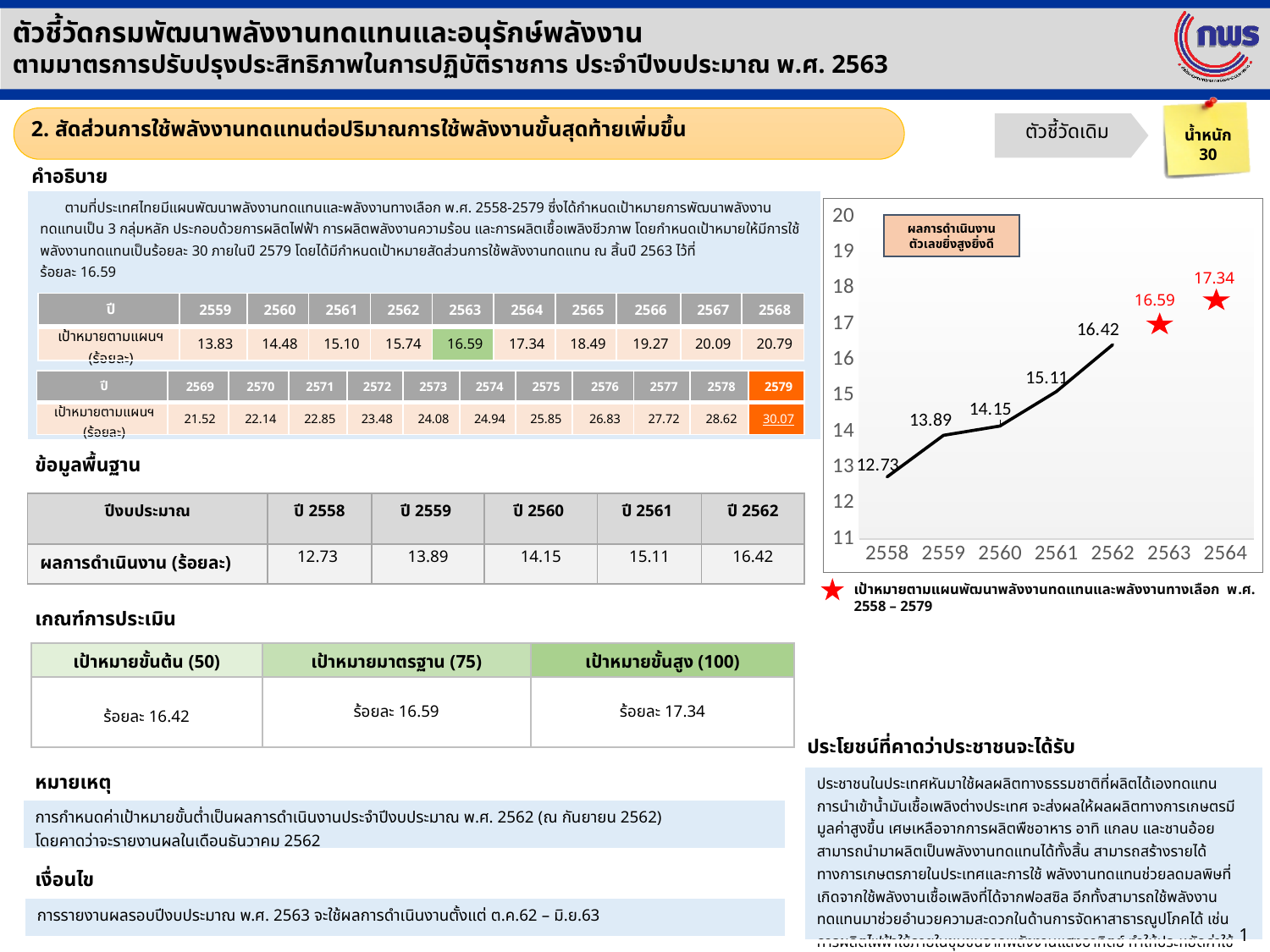
In the line chart, what value is shown by the star marker at 2564? 17.34 In the line chart, what is the value for 2562? 16.42 In the line chart, what is the value for 2560? 14.15 In the line chart, what value is shown by the star marker at 2563? 16.59 In the line chart, which is larger: the value for 2559 or the value for 2560? 2560 In the line chart, which year has the highest value shown? 2564 How many years are labelled on the x axis of the line chart? 7 In the line chart, what is the value for 2558? 12.73 In the line chart, do the values rise or fall from 2558 to 2562? rise In the line chart, what is the difference between the values for 2562 and 2561? 1.31 What type of chart is shown on the right side of the slide? line chart In the line chart, which year on the solid line has the lowest value? 2558